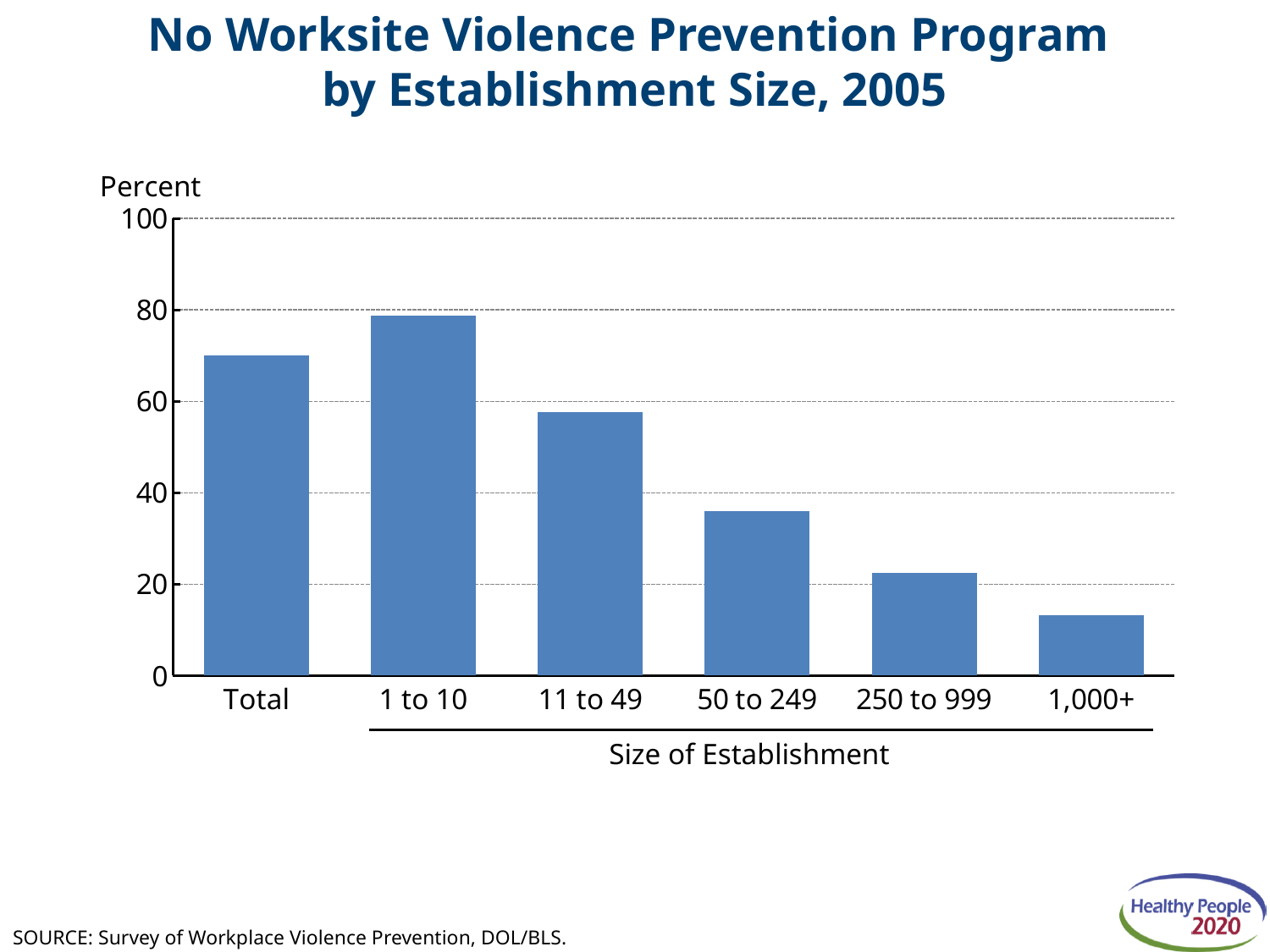
Which category has the lowest percentage of establishments with no worksite violence prevention program? 1,000+ Is the value for the 1,000+ category greater or less than 20? less Is the value for the 1 to 10 category greater or less than 60? greater Is the value for the 50 to 249 category greater or less than 40? less How many establishment size categories (bars) are plotted on the chart? 6 What type of chart is shown on the slide? bar chart Which category has the highest percentage of establishments with no worksite violence prevention program? 1 to 10 Moving from the 1 to 10 category to the 1,000+ category, do the values rise or fall? fall Which is larger, the value for 250 to 999 or the value for 50 to 249? 50 to 249 Which is larger, the value for Total or the value for 11 to 49? Total What is the label of the vertical axis? Percent